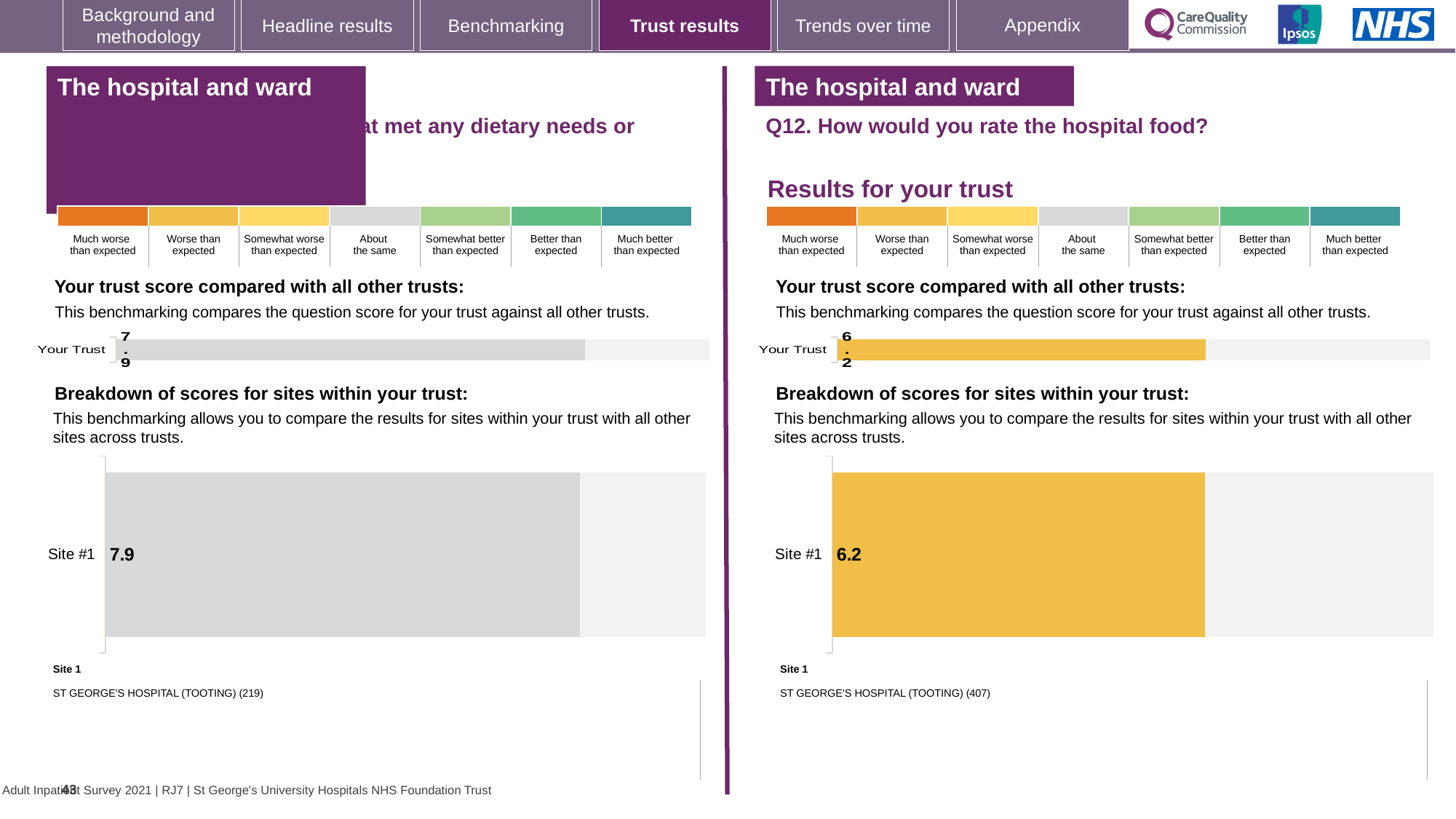
How many sites are shown on the left-hand 'Breakdown of scores for sites within your trust' chart? 1 Which site name is listed as Site 1 beneath the right-hand Q12 breakdown chart? ST GEORGE'S HOSPITAL (TOOTING) (407) What is the difference between the Site #1 score on the left-hand breakdown chart (7.9) and the Site #1 score on the right-hand Q12 breakdown chart (6.2)? 1.7 On the right-hand Q12 chart, is the 'Your Trust' score of 6.2 greater or less than the left-hand 'Your Trust' score of 7.9? less On the left-hand 'Your trust score compared with all other trusts' chart, what is the score shown for 'Your Trust'? 7.9 What colour is the Site #1 bar on the right-hand Q12 breakdown chart? Yellow On the right-hand 'Breakdown of scores for sites within your trust' chart for Q12, what is the score for Site #1? 6.2 What type of chart is used for the Site #1 breakdown on the right-hand side of the slide? Bar chart On the right-hand chart for Q12 (hospital food), what is the trust score shown for 'Your Trust'? 6.2 Which is larger: the Site #1 score on the left-hand breakdown chart or the Site #1 score on the right-hand Q12 breakdown chart? Left-hand chart (7.9) How many sites are shown on the right-hand 'Breakdown of scores for sites within your trust' chart for Q12? 1 On the left-hand 'Breakdown of scores for sites within your trust' chart, what is the score for Site #1? 7.9